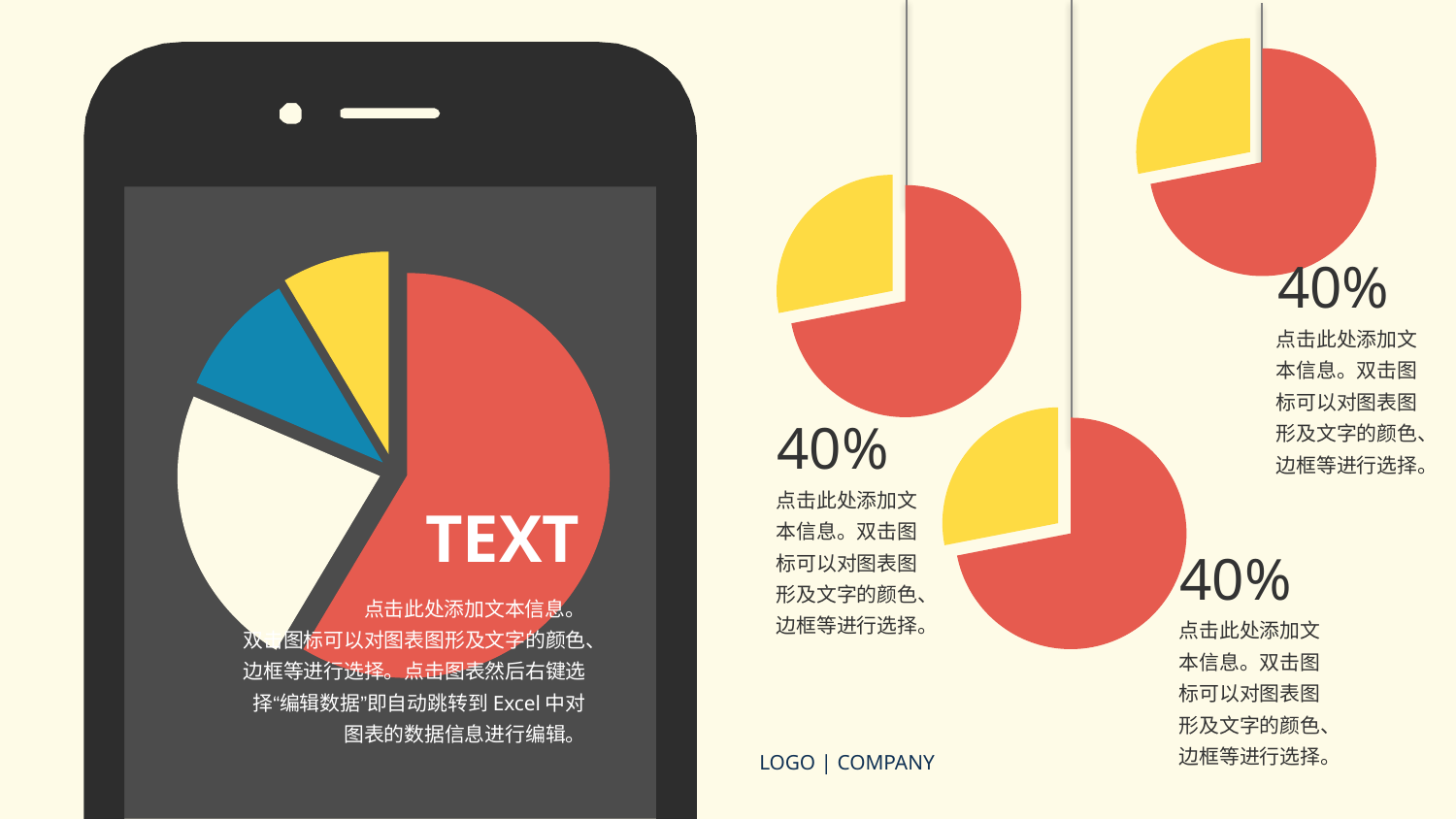
What kind of chart is shown inside the phone on the left of the slide? Pie chart In the small pie chart at the top right of the slide, which slice is larger, the red or the yellow? The red slice How many slices does each of the three small pie charts on the right side of the slide have? 2 In the large pie chart inside the phone, is the red slice or the white slice larger? The red slice In the large pie chart inside the phone, is the red slice greater or less than 50% of the pie? greater In the small pie chart in the middle of the right side, is the yellow slice greater or less than 50% of the pie? less In the large pie chart inside the phone, which slice is the largest? The red slice What text label is printed on the red slice of the large pie chart inside the phone? TEXT How many slices does the large pie chart inside the phone have? 4 In the large pie chart inside the phone, is the white slice or the blue slice larger? The white slice What colours are used for the slices of the large pie chart inside the phone? Red, white, blue and yellow How many pie charts are shown on the slide in total? 4